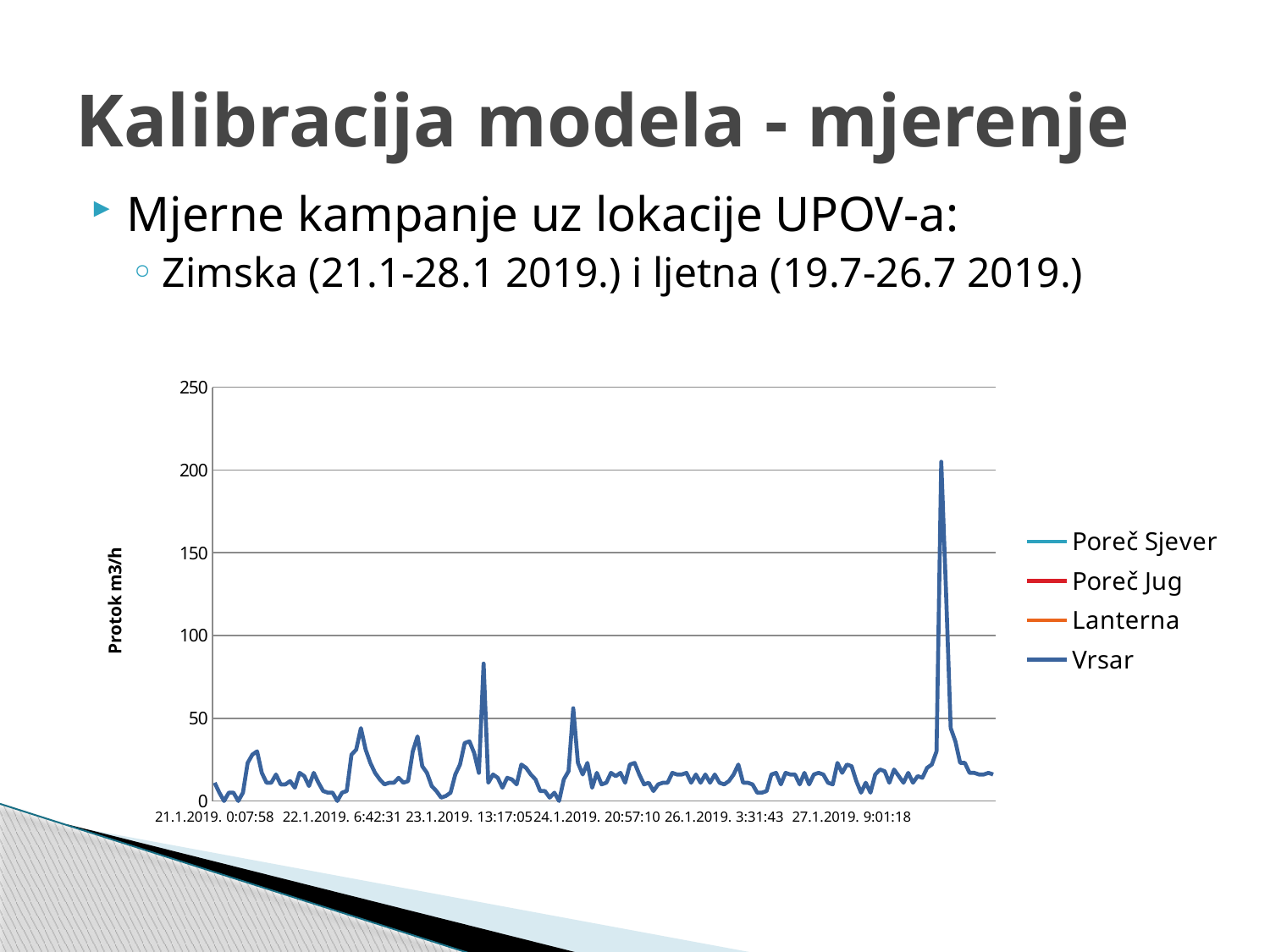
Is the peak of the Vrsar line near 23.1.2019. 13:17:05 greater or less than 50? greater What kind of chart is shown on the slide? line chart Is the highest peak of the Vrsar line greater or less than 200? greater What is the label on the vertical axis of the chart? Protok m3/h How many series does the chart's legend list? 4 Is the peak of the Vrsar line near 23.1.2019. 13:17:05 greater or less than 100? less What is the highest value shown on the vertical axis of the chart? 250 Which series is listed last in the chart's legend? Vrsar